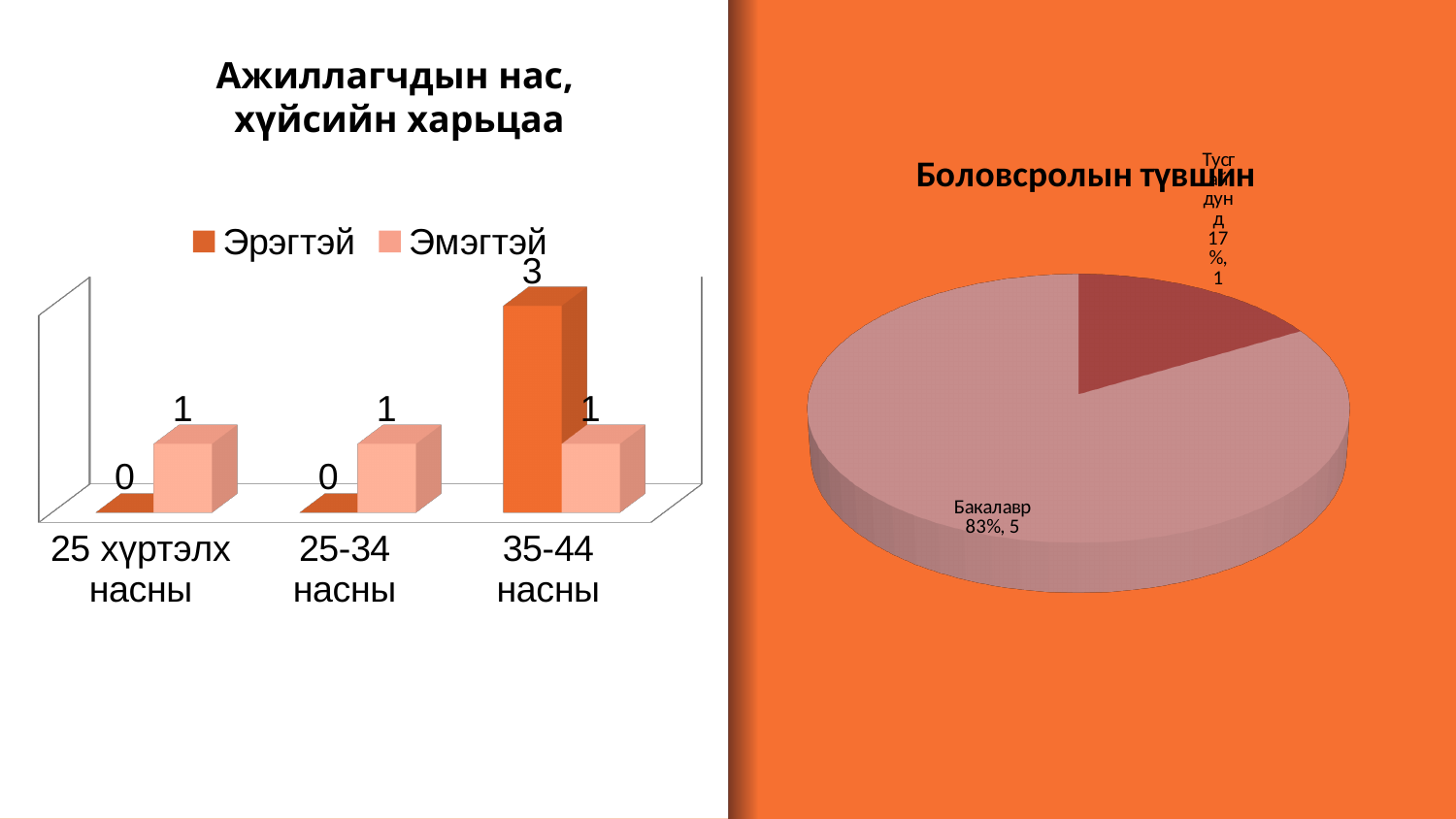
In the chart titled 'Ажиллагчдын нас, хүйсийн харьцаа', what is the difference between the Эрэгтэй and Эмэгтэй values in the '35-44 насны' category? 2 In the chart titled 'Ажиллагчдын нас, хүйсийн харьцаа', which is larger in the '25-34 насны' category: Эрэгтэй or Эмэгтэй? Эмэгтэй In the chart titled 'Ажиллагчдын нас, хүйсийн харьцаа', how many age categories are shown on the x axis? 3 In the chart titled 'Ажиллагчдын нас, хүйсийн харьцаа', what is the value for Эрэгтэй in the '25 хүртэлх насны' category? 0 What kind of chart is the one titled 'Боловсролын түвшин'? Pie chart In the chart titled 'Ажиллагчдын нас, хүйсийн харьцаа', what is the value for Эмэгтэй in the '25-34 насны' category? 1 In the chart titled 'Ажиллагчдын нас, хүйсийн харьцаа', what is the value for Эрэгтэй in the '35-44 насны' category? 3 In the chart titled 'Ажиллагчдын нас, хүйсийн харьцаа', how many series does the legend list? 2 In the chart titled 'Ажиллагчдын нас, хүйсийн харьцаа', which category has the highest value for Эрэгтэй? 35-44 насны In the chart titled 'Боловсролын түвшин', what share of the pie does Бакалавр have? 83% What kind of chart is the one titled 'Ажиллагчдын нас, хүйсийн харьцаа'? Bar chart In the chart titled 'Боловсролын түвшин', what is the value shown for Бакалавр? 5